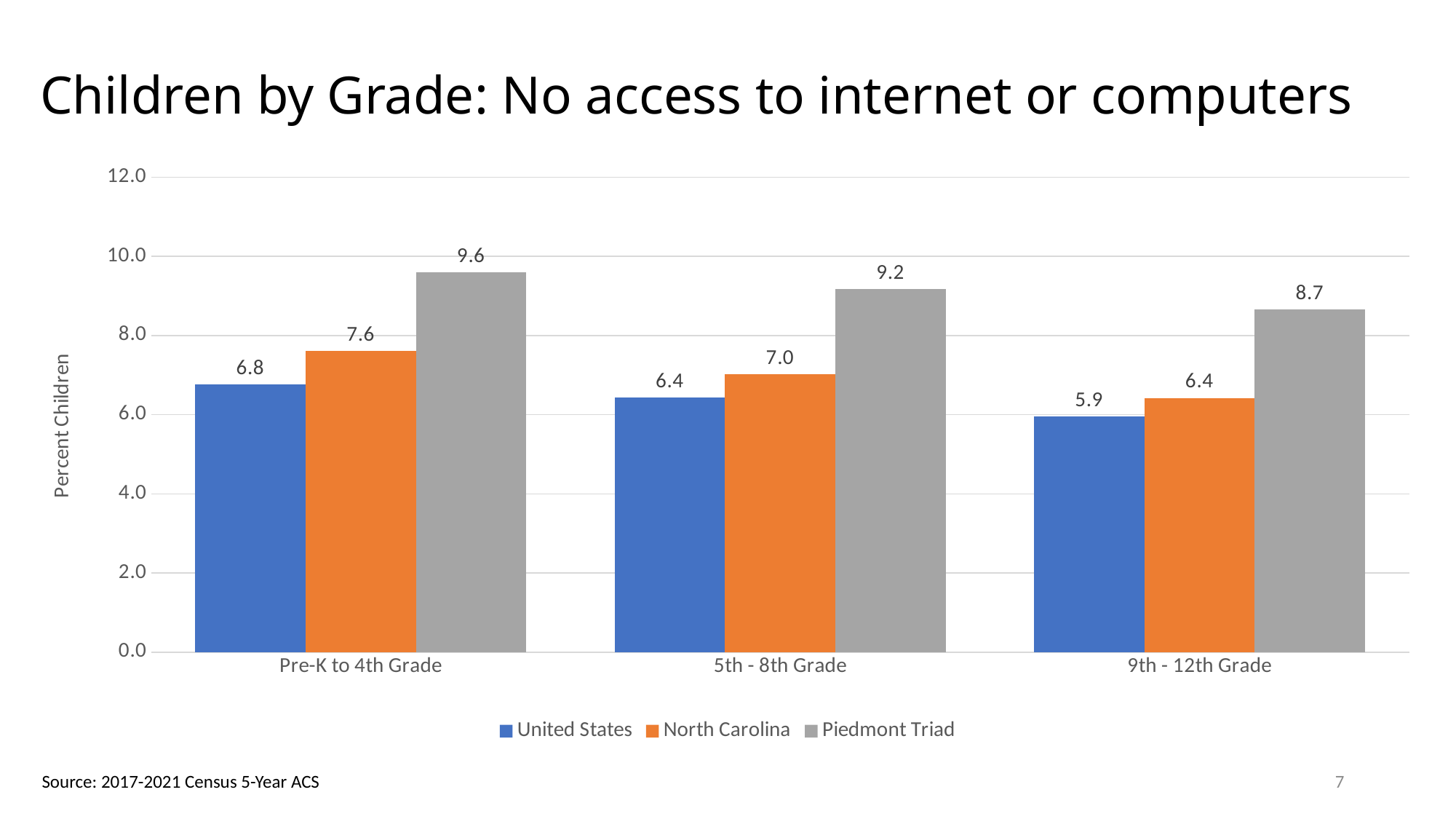
How many grade categories are shown on the x axis? 3 What is the value for North Carolina in the 5th - 8th Grade category? 7.0 What is the value for United States in the 9th - 12th Grade category? 5.9 Which grade category has the highest value for Piedmont Triad? Pre-K to 4th Grade How many series does the legend list? 3 Which is larger in the Pre-K to 4th Grade category: North Carolina or United States? North Carolina What is the value for Piedmont Triad in the Pre-K to 4th Grade category? 9.6 What kind of chart is shown on the slide? Bar chart What is the difference between the Piedmont Triad and United States values in the 9th - 12th Grade category? 2.8 Do the United States values rise or fall from Pre-K to 4th Grade to 9th - 12th Grade? Fall Which grade category has the lowest value for United States? 9th - 12th Grade Is the value for Piedmont Triad in the 5th - 8th Grade category greater or less than 8.0? greater